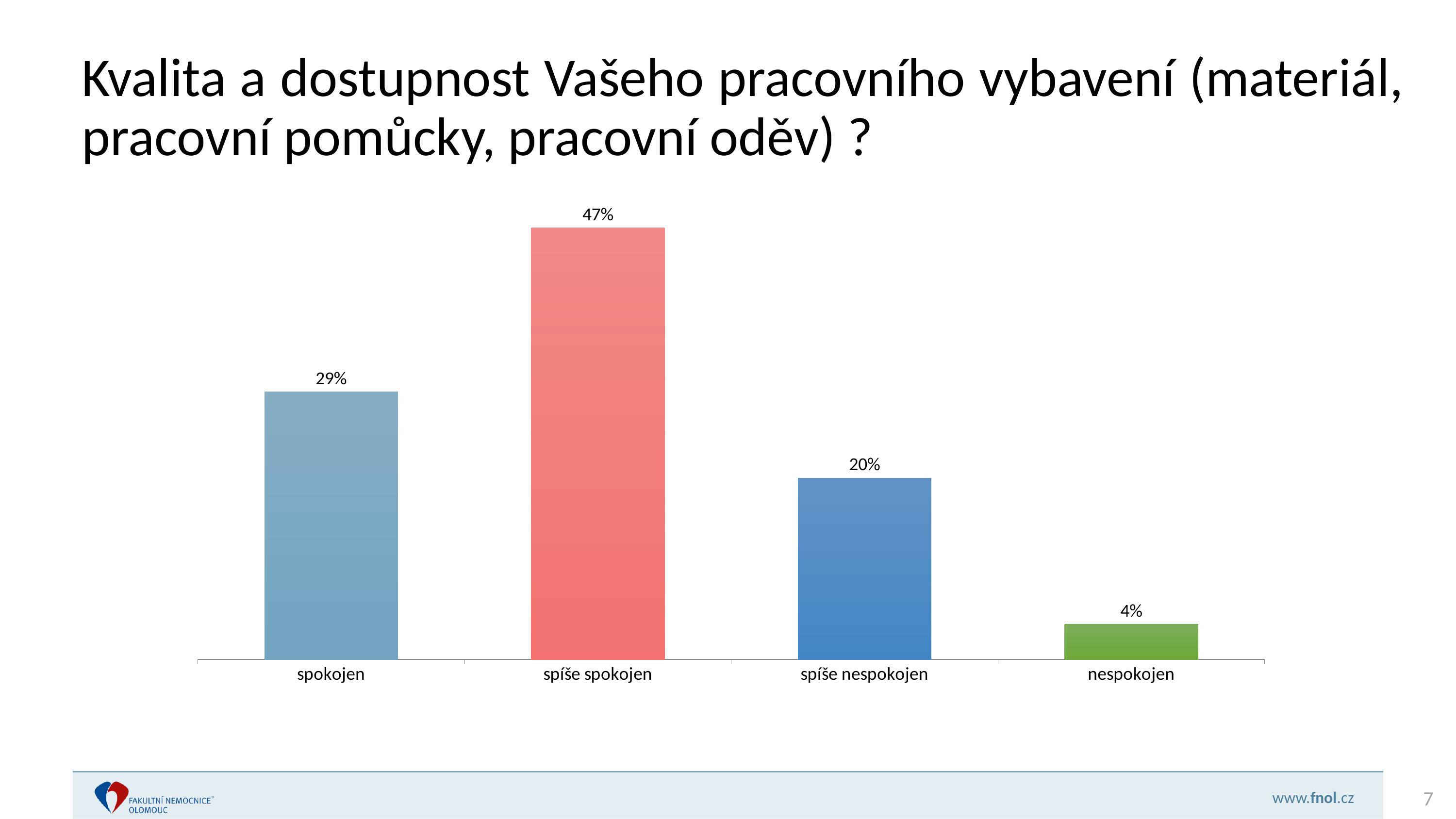
Which is larger, the value for "spokojen" or the value for "spíše nespokojen"? spokojen How many categories are shown on the chart? 4 What is the value for "nespokojen"? 4% Which category has the highest value? spíše spokojen What colour is the bar for "spíše spokojen"? red What is the difference between the values for "spíše nespokojen" and "nespokojen"? 16% What is the value for "spíše nespokojen"? 20% Which category has the lowest value? nespokojen What is the difference between the values for "spíše spokojen" and "spokojen"? 18% What is the value for "spíše spokojen"? 47% What kind of chart is shown on the slide? bar chart What is the value for "spokojen"? 29%